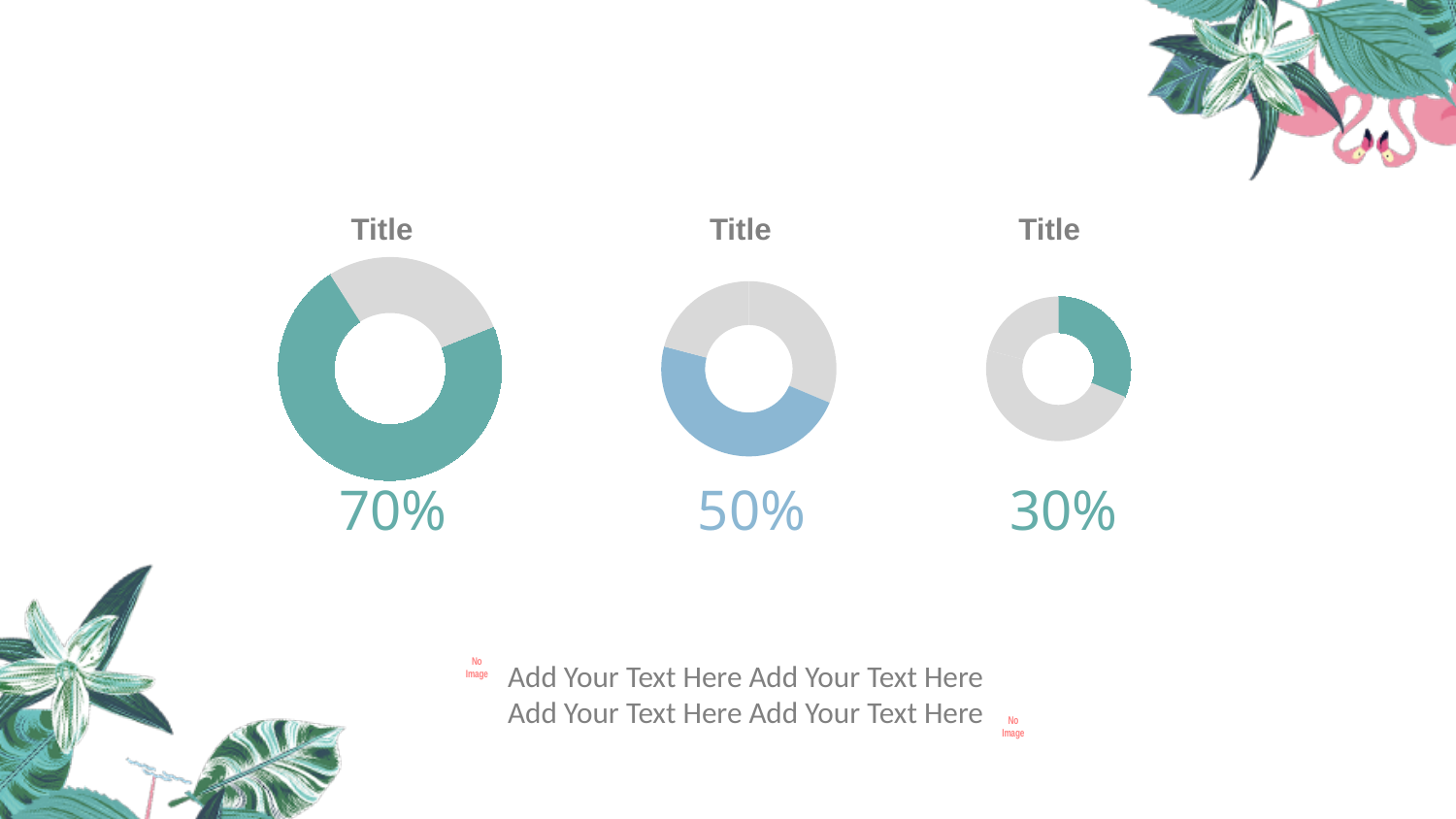
What percentage is shown below the right donut chart? 30% Which donut chart shows the highest percentage: left, middle or right? Left What is the difference between the percentages of the left and right donut charts? 40% Which is larger, the percentage of the left donut chart or the right donut chart? Left (70%) What kind of chart is used for each of the three charts on the slide? Donut chart What percentage is shown below the middle donut chart? 50% What is the title shown above each of the three donut charts? Title What is the difference between the percentages of the left and middle donut charts? 20% What percentage is shown below the left donut chart? 70% What colour is the filled portion of the middle donut chart? Blue How many donut charts are on the slide? 3 Which donut chart shows the lowest percentage: left, middle or right? Right